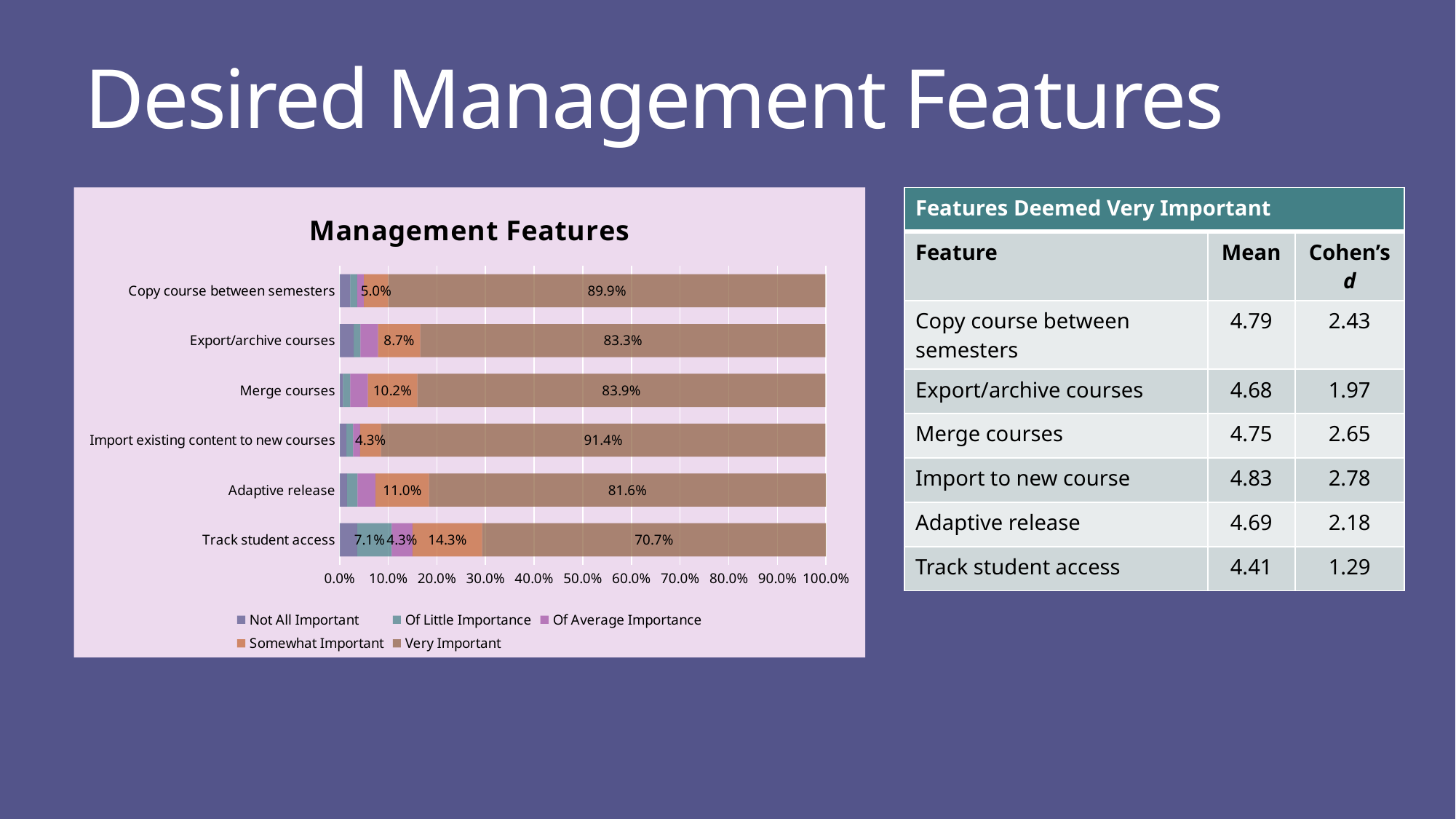
What kind of chart is the Management Features chart? Stacked bar chart In the Management Features chart, which has a larger Very Important percentage: 'Merge courses' or 'Adaptive release'? Merge courses How many features are listed in the Management Features chart? 6 In the Management Features chart, what percentage rated 'Import existing content to new courses' as Very Important? 91.4% In the Management Features chart, what is the difference in percentage points between the Very Important values for 'Copy course between semesters' and 'Export/archive courses'? 6.6 In the Management Features chart, which feature has the lowest Very Important percentage? Track student access How many series does the legend of the Management Features chart list? 5 In the Management Features chart, what is the Somewhat Important percentage for 'Adaptive release'? 11.0% In the Management Features chart, which feature has the highest Very Important percentage? Import existing content to new courses In the Management Features chart, what is the Very Important percentage for 'Export/archive courses'? 83.3% In the Management Features chart, is the Somewhat Important value for 'Copy course between semesters' greater or less than 10.0%? less